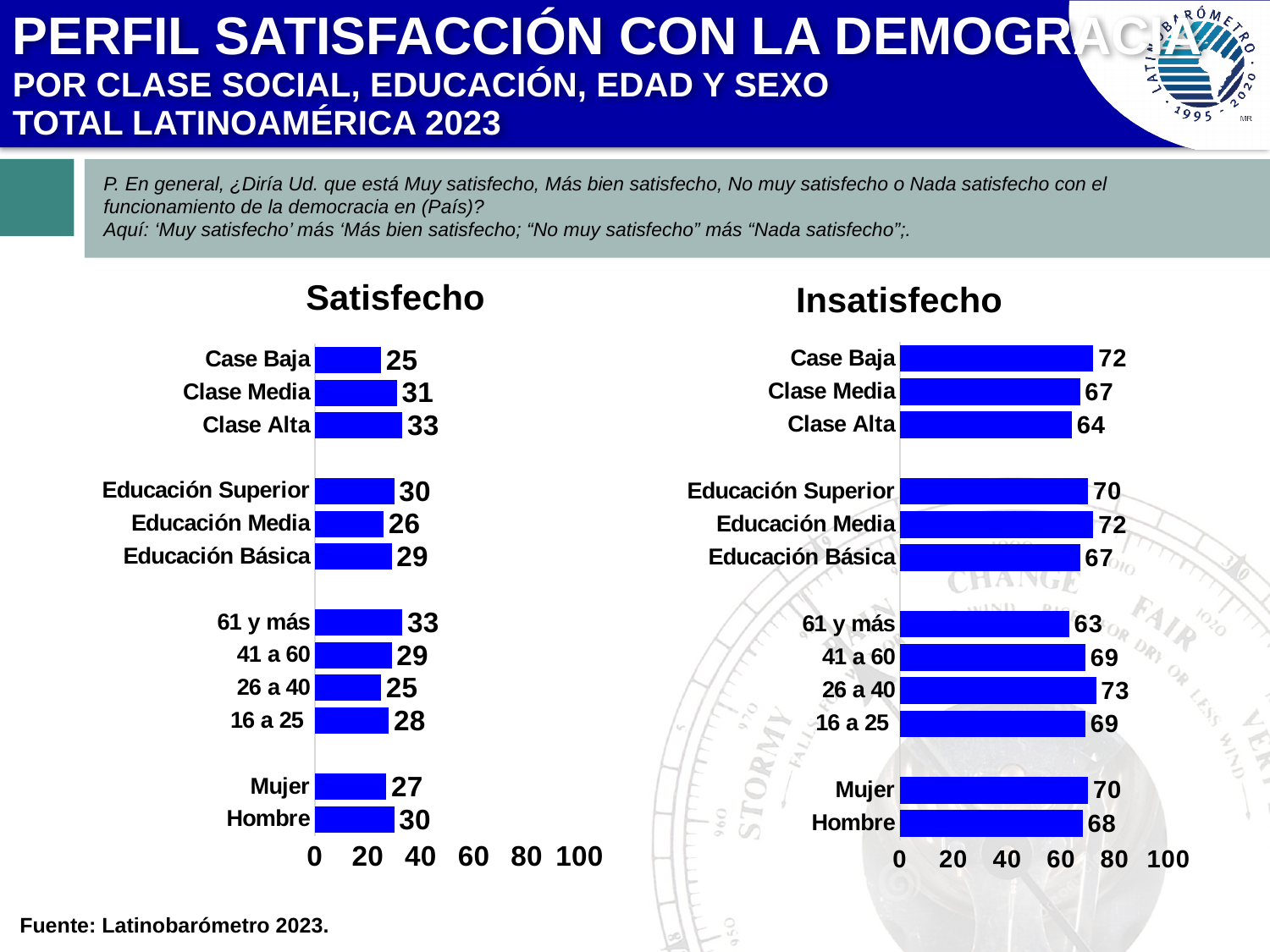
In the Satisfecho chart, what is the difference between the values for Clase Alta and Case Baja? 8 In the Satisfecho chart, what is the value for Hombre? 30 What kind of chart is the Insatisfecho chart? bar chart In the Insatisfecho chart, what is the value for Educación Superior? 70 How many categories are shown in the Satisfecho chart? 12 In the Insatisfecho chart, which category has the highest value? 26 a 40 In the Satisfecho chart, which is larger, the value for Educación Superior or the value for Educación Media? Educación Superior In the Insatisfecho chart, is the value for Clase Alta greater or less than 60? greater In the Insatisfecho chart, what is the difference between the values for Mujer and Hombre? 2 In the Satisfecho chart, what is the value for Clase Media? 31 In the Insatisfecho chart, which category has the lowest value? 61 y más In the Insatisfecho chart, what is the value for 16 a 25? 69